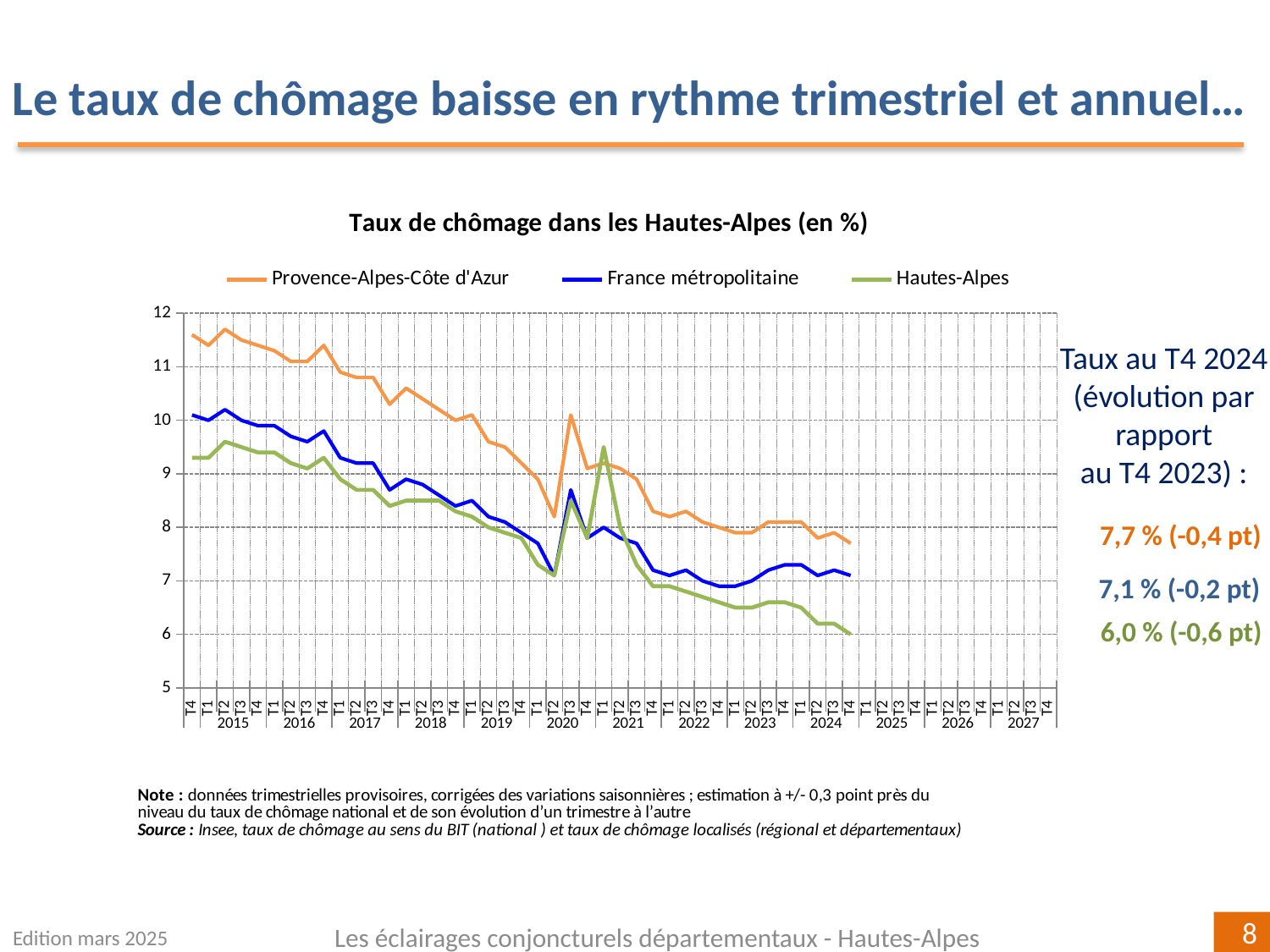
How many series does the legend of the chart list? 3 Which series has the lowest value at T4 2024? Hautes-Alpes What is the unemployment rate for Provence-Alpes-Côte d'Azur at T4 2024? 7,7 % At T4 2024, which is higher: the rate for Provence-Alpes-Côte d'Azur or for France métropolitaine? Provence-Alpes-Côte d'Azur Overall, do the unemployment rates rise or fall between 2015 and 2024? Fall What kind of chart is shown on the slide? Line chart Is the value for Hautes-Alpes at T1 2021 greater or less than 9? greater By how many points did the Hautes-Alpes rate change between T4 2023 and T4 2024? -0,6 pt What is the title of the chart? Taux de chômage dans les Hautes-Alpes (en %) What is the unemployment rate for France métropolitaine at T4 2024? 7,1 % What is the difference between the Provence-Alpes-Côte d'Azur rate and the Hautes-Alpes rate at T4 2024? 1,7 pt What is the unemployment rate for Hautes-Alpes at T4 2024? 6,0 %